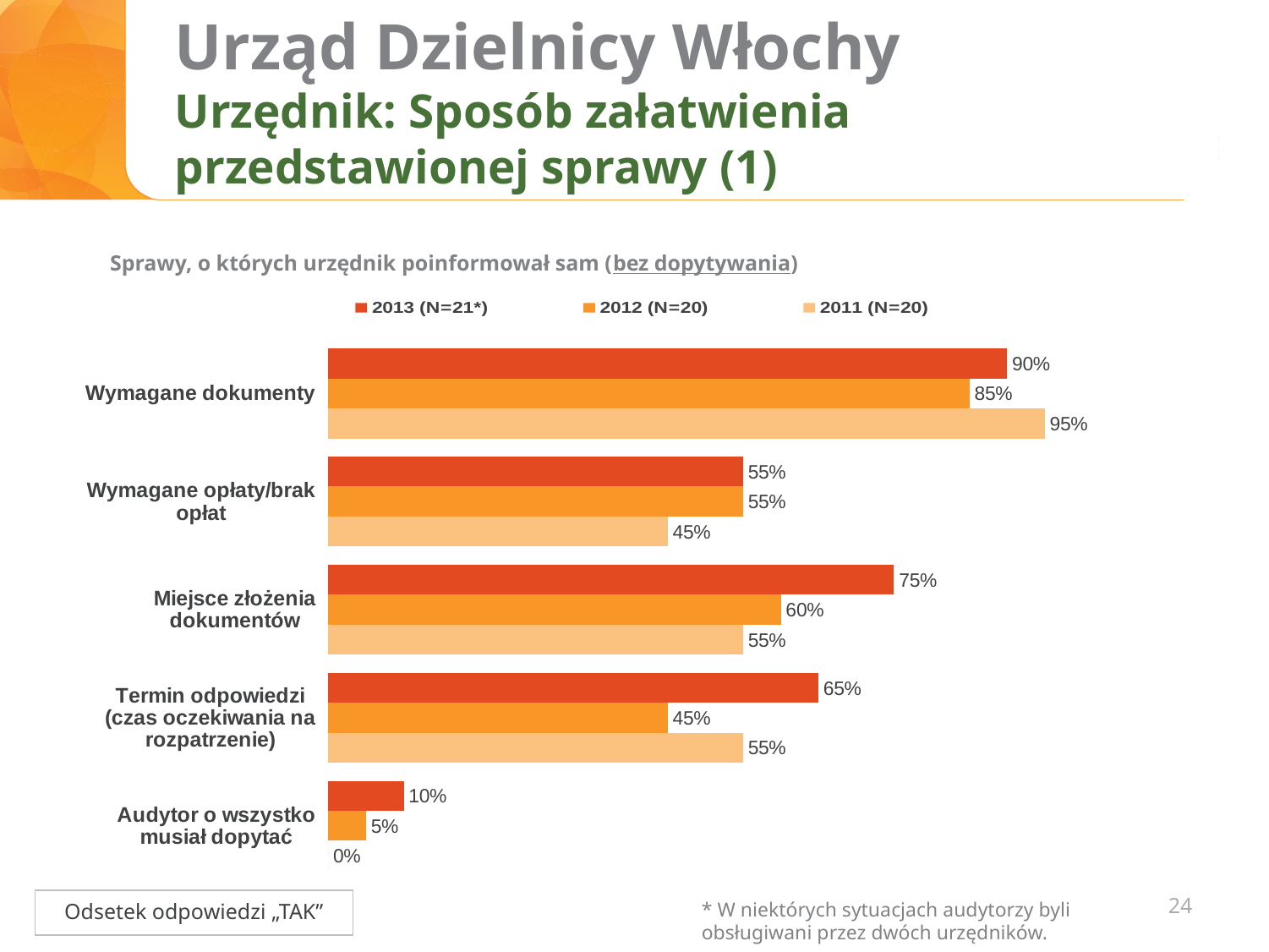
What is the value for "Audytor o wszystko musiał dopytać" in the 2011 (N=20) series? 0% Which is larger for "Wymagane dokumenty": the 2012 (N=20) value or the 2011 (N=20) value? 2011 (N=20) Which category has the highest value in the 2011 (N=20) series? Wymagane dokumenty What is the difference between the 2013 (N=21*) and 2012 (N=20) values for "Miejsce złożenia dokumentów"? 15% Which category has the lowest value in the 2013 (N=21*) series? Audytor o wszystko musiał dopytać What kind of chart is shown on the slide? Bar chart What is the difference between the 2013 (N=21*) and 2011 (N=20) values for "Wymagane opłaty/brak opłat"? 10% What is the value for "Wymagane dokumenty" in the 2013 (N=21*) series? 90% How many categories are shown on the chart? 5 What is the subtitle printed above the chart? Sprawy, o których urzędnik poinformował sam (bez dopytywania) What is the value for "Termin odpowiedzi (czas oczekiwania na rozpatrzenie)" in the 2012 (N=20) series? 45% How many series does the legend list? 3